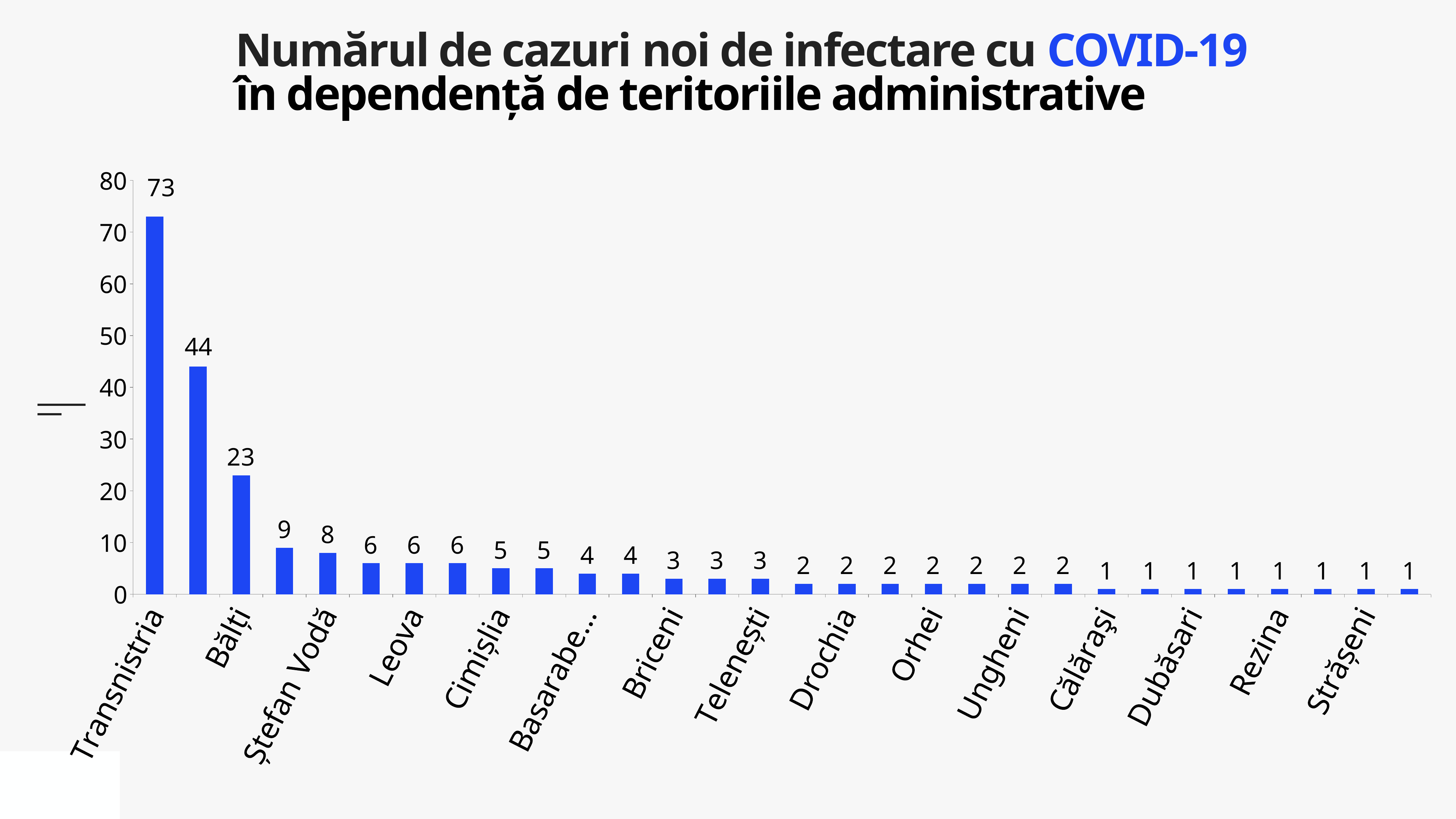
Is the value for Transnistria greater or less than 70? greater What type of chart is shown on the slide? bar chart Which territory has the highest number of new COVID-19 cases? Transnistria Do the values rise or fall from left to right along the x axis? fall What is the difference between the highest bar (73) and the second highest bar (44)? 29 What is the value for Strășeni? 1 What is the value for Leova? 6 What is the value for Drochia? 2 What is the value for Transnistria? 73 Which is larger, the value for Transnistria or the value for Leova? Transnistria How many bars are plotted in the chart? 30 What is the value for Telenești? 3